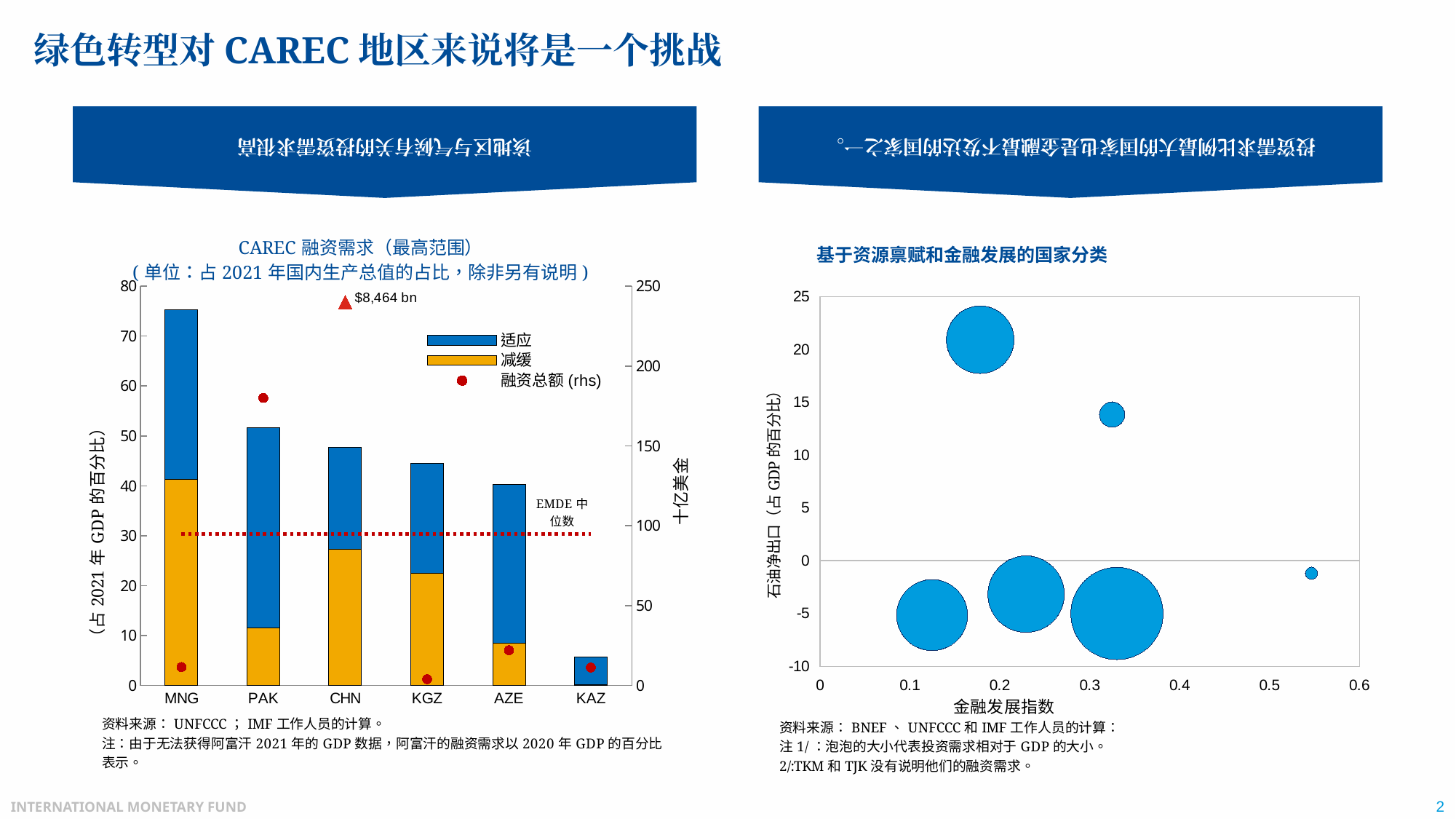
In the left chart 'CAREC 融资需求（最高范围）', which country has the tallest stacked bar? MNG In the left chart 'CAREC 融资需求（最高范围）', how many countries are shown on the x axis? 6 In the left chart 'CAREC 融资需求（最高范围）', how many series does the legend list? 3 In the left chart 'CAREC 融资需求（最高范围）', is the total bar height for KAZ greater or less than 10? less In the left chart 'CAREC 融资需求（最高范围）', which country has the shortest stacked bar? KAZ In the right chart '基于资源禀赋和金融发展的国家分类', what is the x-axis title? 金融发展指数 In the left chart 'CAREC 融资需求（最高范围）', which has the taller stacked bar, MNG or PAK? MNG What kind of chart is the right chart titled '基于资源禀赋和金融发展的国家分类'? Bubble chart In the left chart 'CAREC 融资需求（最高范围）', what value is printed next to the triangle marker above CHN? $8,464 bn What kind of chart is the left chart titled 'CAREC 融资需求（最高范围）'? Stacked bar chart In the left chart 'CAREC 融资需求（最高范围）', is the total bar height for MNG greater or less than 70? greater In the right chart '基于资源禀赋和金融发展的国家分类', how many bubbles are plotted? 6